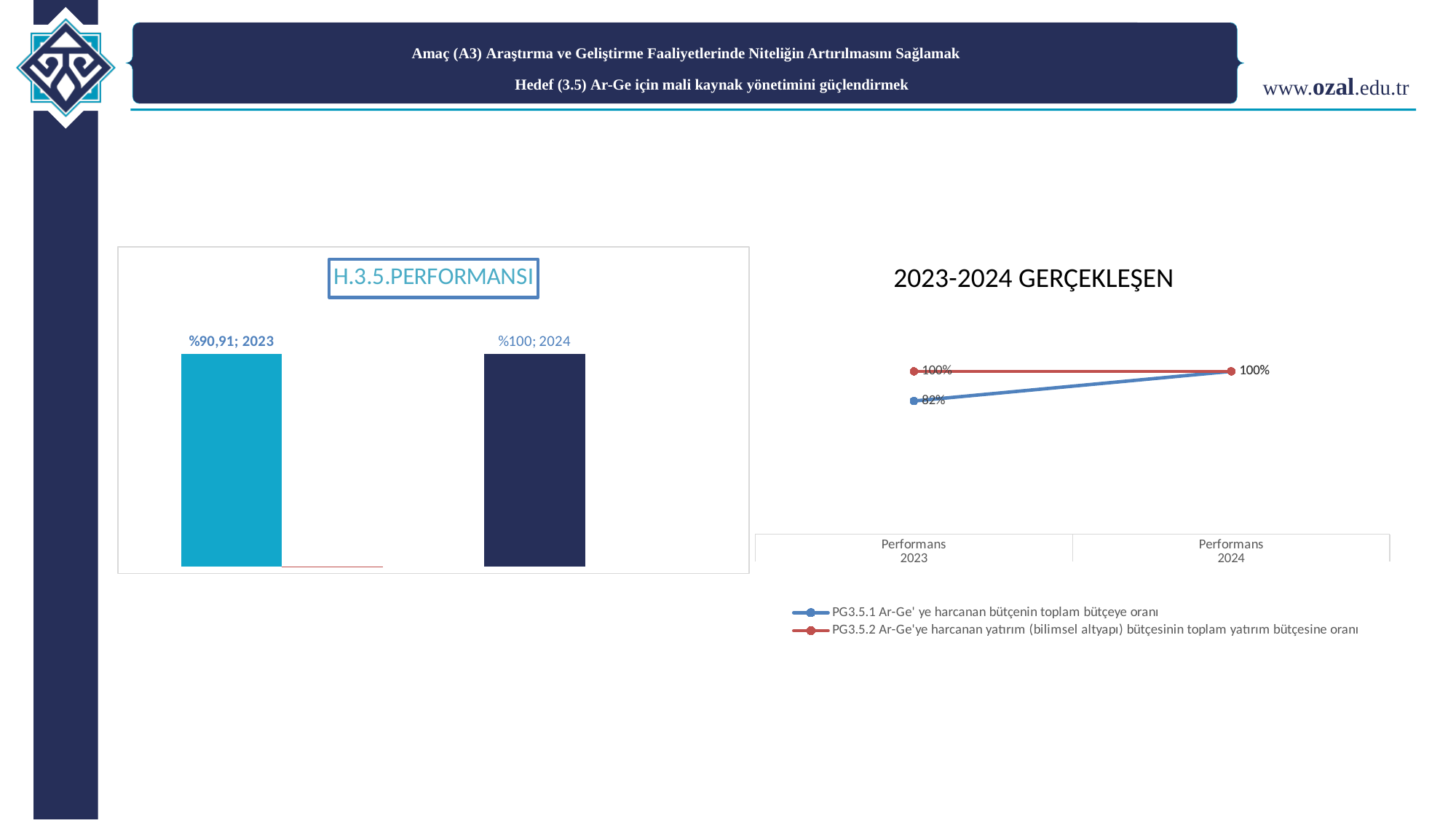
In the H.3.5.PERFORMANSI chart, which year has the higher value? 2024 How many series does the legend of the 2023-2024 GERÇEKLEŞEN chart list? 2 In the 2023-2024 GERÇEKLEŞEN chart, does the PG3.5.1 series rise or fall from Performans 2023 to Performans 2024? rise In the 2023-2024 GERÇEKLEŞEN chart, what is the value of PG3.5.1 Ar-Ge' ye harcanan bütçenin toplam bütçeye oranı for Performans 2024? 100% In the 2023-2024 GERÇEKLEŞEN chart, what is the value of PG3.5.1 Ar-Ge' ye harcanan bütçenin toplam bütçeye oranı for Performans 2023? 82% In the H.3.5.PERFORMANSI chart, what is the value for 2024? %100 In the 2023-2024 GERÇEKLEŞEN chart, what is the difference between the PG3.5.1 values for Performans 2024 and Performans 2023? 18% What kind of chart is the H.3.5.PERFORMANSI chart? bar chart In the H.3.5.PERFORMANSI chart, what is the value for 2023? %90,91 In the H.3.5.PERFORMANSI chart, which year has the lower value? 2023 In the 2023-2024 GERÇEKLEŞEN chart, what is the value of PG3.5.2 for Performans 2023? 100% How many bars are shown in the H.3.5.PERFORMANSI chart? 2